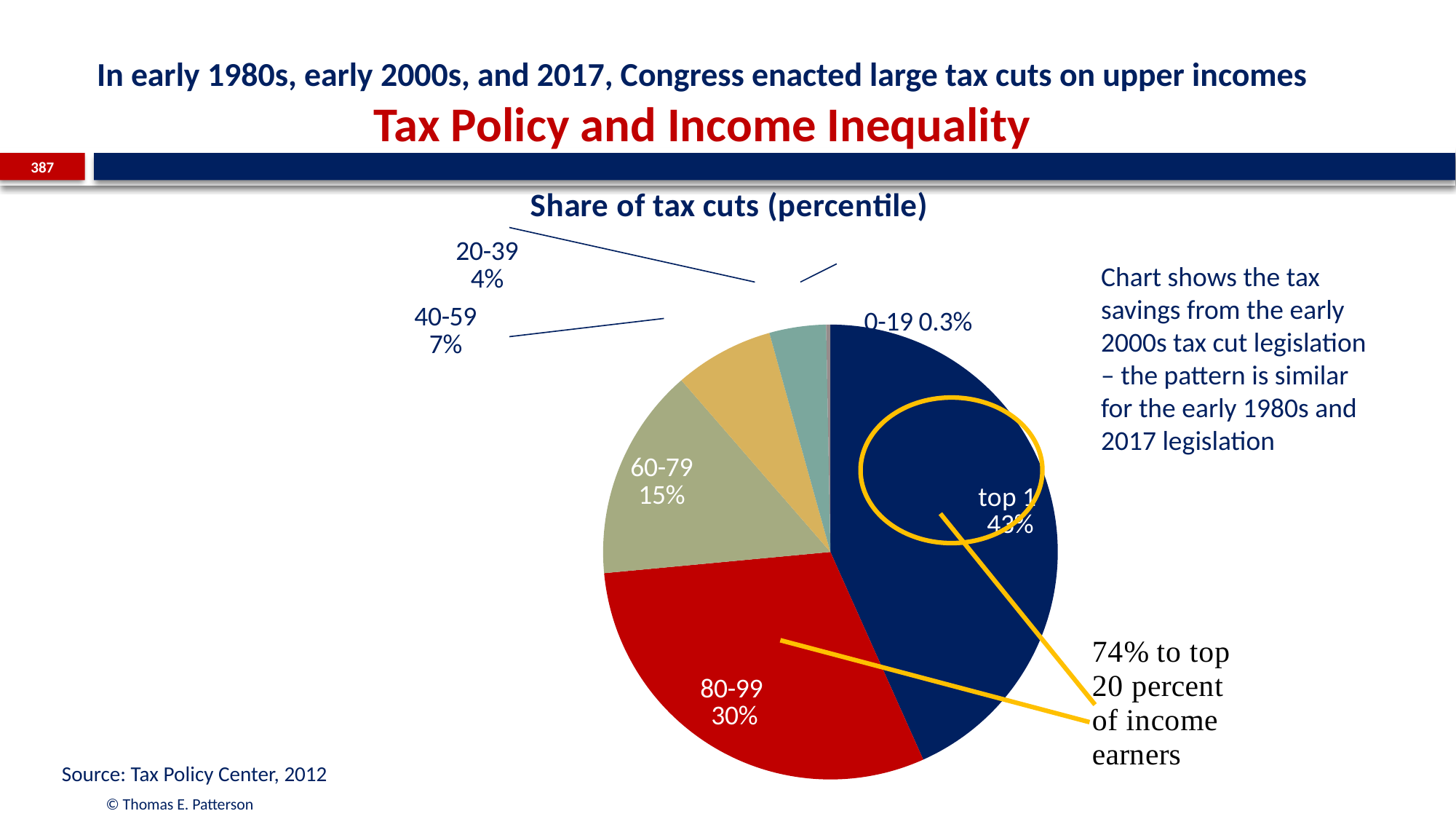
What kind of chart is shown on the slide? pie chart What share of the tax cuts went to the 40-59 percentile? 7% How many slices does the pie chart have? 6 What share of the tax cuts went to the 80-99 percentile? 30% Which percentile group received the smallest share of the tax cuts? 0-19 What share of the tax cuts went to the 60-79 percentile? 15% What share of the tax cuts went to the 20-39 percentile? 4% How many percentage points larger is the 80-99 share than the 60-79 share? 15 What share of the tax cuts went to the 0-19 percentile? 0.3% Which percentile group received the largest share of the tax cuts? top 1 What is the title of the chart? Share of tax cuts (percentile) Which received a larger share of the tax cuts, the 60-79 percentile or the 40-59 percentile? 60-79